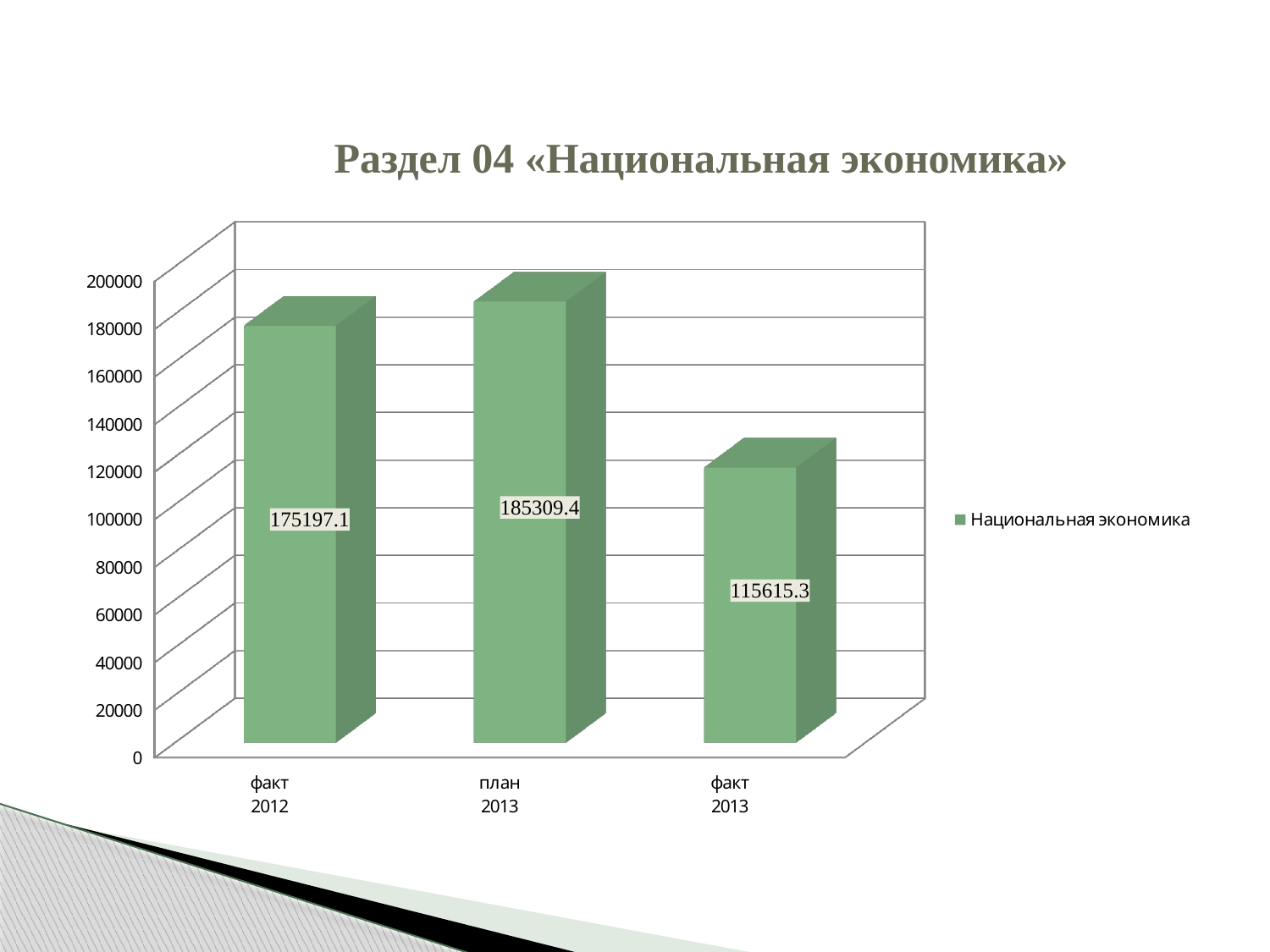
What kind of chart is shown on the slide? bar chart Which category has the highest value? план 2013 What is the value for факт 2013? 115615.3 What series name does the legend list? Национальная экономика What is the value for факт 2012? 175197.1 What is the difference between план 2013 and факт 2013? 69694.1 What is the value for план 2013? 185309.4 Is the value for факт 2013 greater or less than 120000? less How many categories are shown on the x axis? 3 What is the difference between план 2013 and факт 2012? 10112.3 Which category has the lowest value? факт 2013 Which is larger, факт 2012 or факт 2013? факт 2012